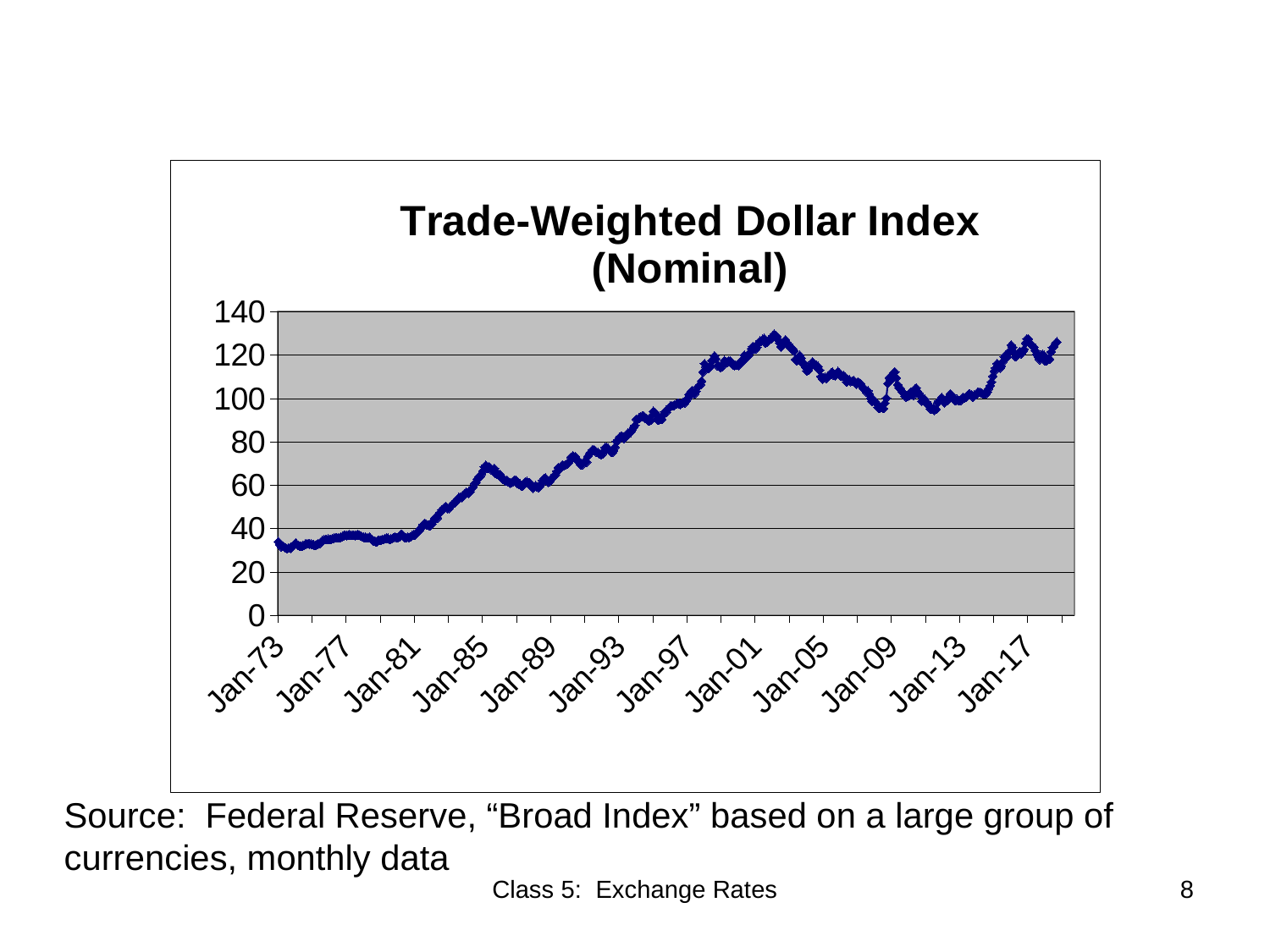
Is the value at Jan-85 greater or less than 60? greater How many date labels are shown on the x axis? 12 Is the value at Jan-73 greater or less than 40? less What is the highest value shown on the y axis? 140 What is the title of the chart? Trade-Weighted Dollar Index (Nominal) What kind of chart is shown on the slide? line chart Is the value at Jan-81 greater or less than 60? less Overall, does the index rise or fall from Jan-73 to Jan-17? rise